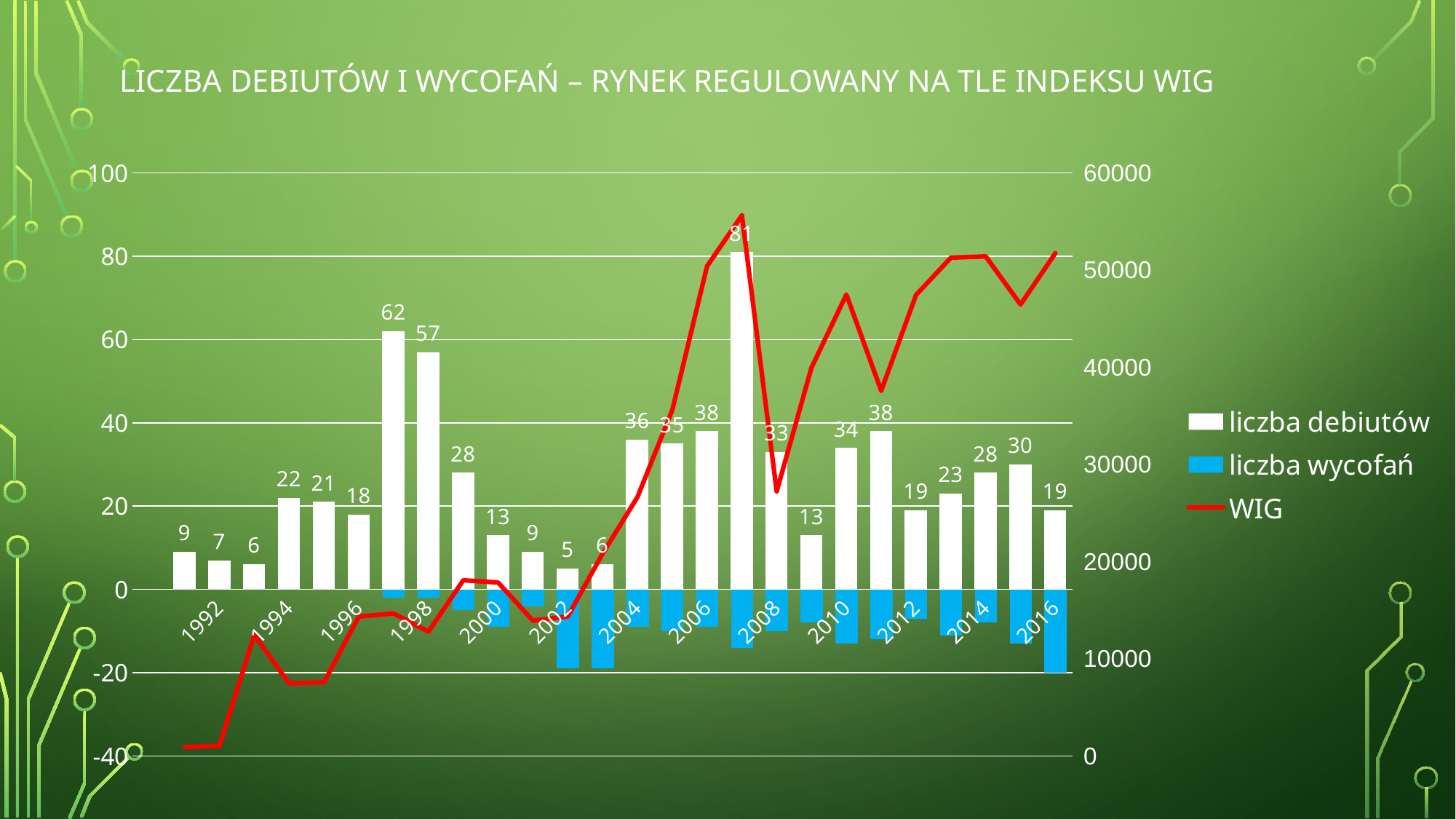
What colour is the WIG line? Red How many series does the legend list? 3 What is the value of liczba debiutów for 2016? 19 Which year has the larger liczba debiutów, 2010 or 2012? 2010 Does the WIG line generally rise or fall from 1992 to 2016? Rise What is the difference between liczba debiutów in 1998 and in 2000? 44 Is the WIG value for 1992 greater or less than 10000? less What is the value of liczba debiutów for 1998? 57 What kind of chart is shown on the slide? Combined bar and line chart Is the WIG value for 2016 greater or less than 40000? greater What is the value of liczba debiutów for 2006? 38 What is the highest value of liczba debiutów shown on the chart? 81